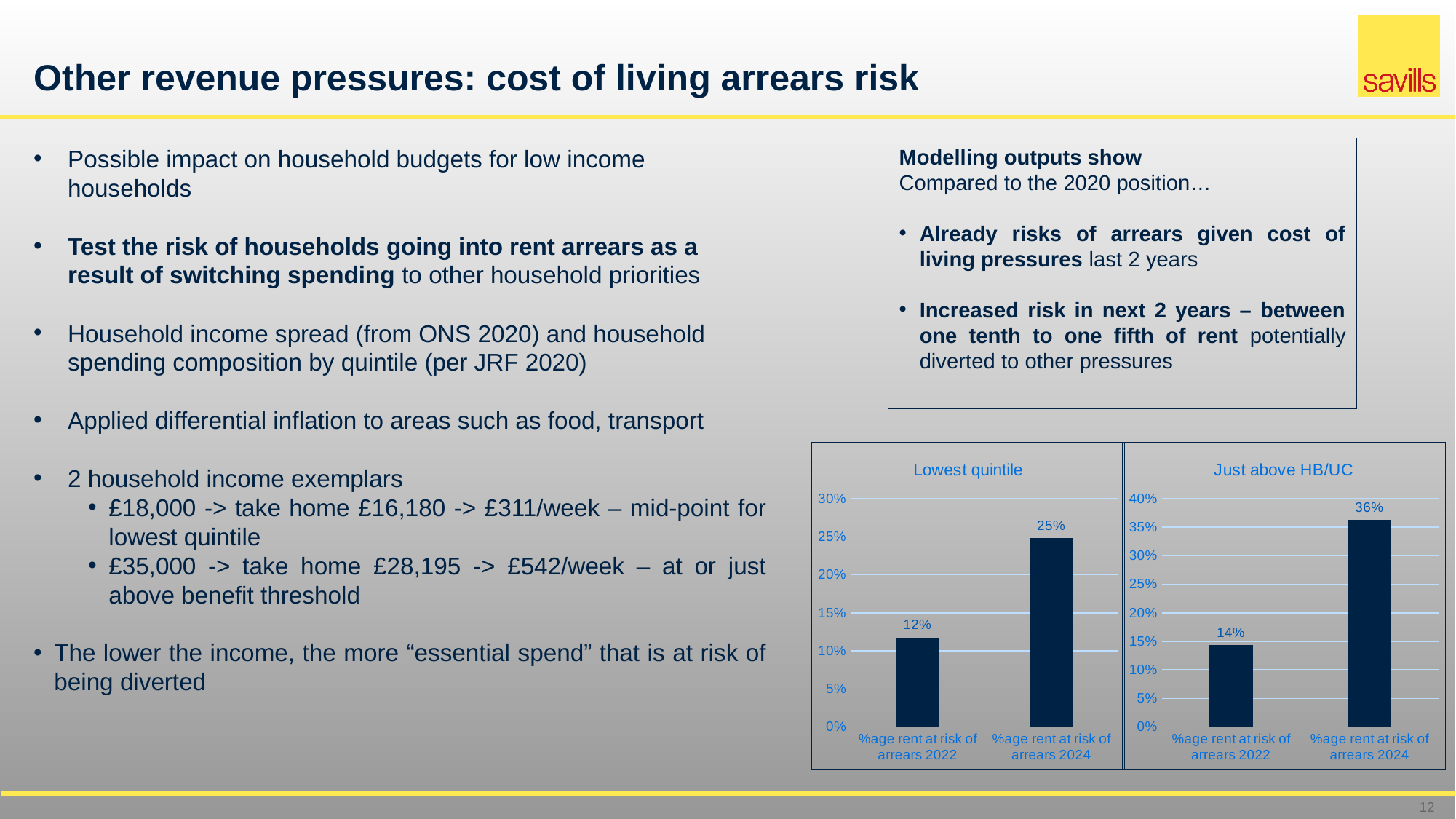
In the 'Just above HB/UC' chart, what is the difference between the 2024 and 2022 values? 22% In the 'Just above HB/UC' chart, do the values rise or fall from 2022 to 2024? Rise In the 'Just above HB/UC' chart, what is the value for '%age rent at risk of arrears 2024'? 36% In the 'Just above HB/UC' chart, what is the value for '%age rent at risk of arrears 2022'? 14% In the 'Lowest quintile' chart, what is the value for '%age rent at risk of arrears 2024'? 25% In the 'Lowest quintile' chart, which category has the lowest value? %age rent at risk of arrears 2022 In the 'Lowest quintile' chart, what is the difference between the 2024 and 2022 values? 13% In the 'Just above HB/UC' chart, which category has the highest value? %age rent at risk of arrears 2024 How many categories are shown in the 'Just above HB/UC' chart? 2 Which is larger: the 2022 value in the 'Lowest quintile' chart or the 2022 value in the 'Just above HB/UC' chart? Just above HB/UC In the 'Lowest quintile' chart, what is the value for '%age rent at risk of arrears 2022'? 12% What kind of chart is the 'Lowest quintile' chart? Bar chart